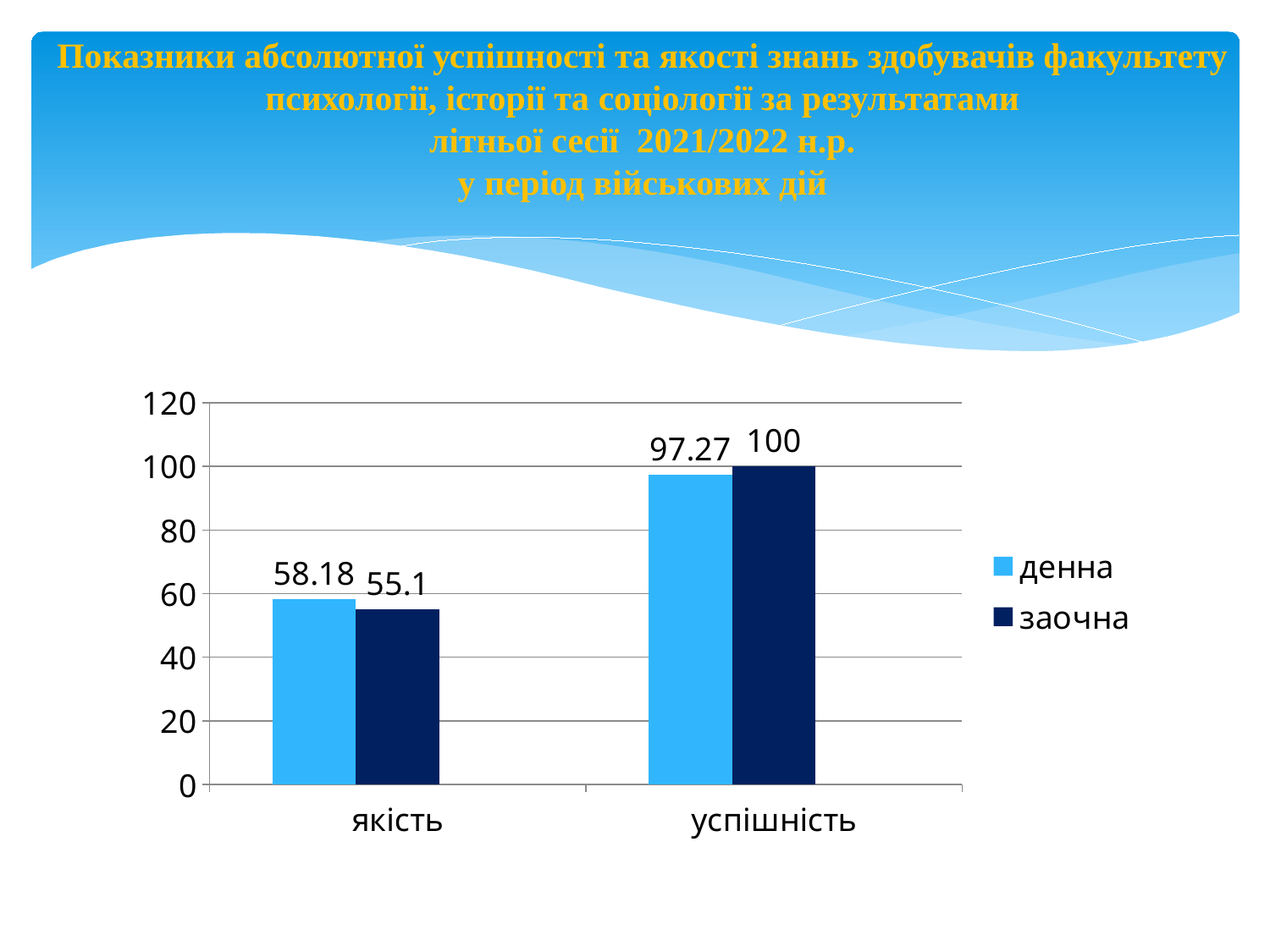
What is the value for заочна in the успішність category? 100 What is the difference between the заочна and денна values in the успішність category? 2.73 What kind of chart is shown on the slide? bar chart Which category has the lowest value for заочна? якість What is the value for денна in the якість category? 58.18 Which series has the higher value in the успішність category? заочна What is the value for заочна in the якість category? 55.1 What is the value for денна in the успішність category? 97.27 Which series has the higher value in the якість category? денна How many series does the legend list? 2 What is the difference between the денна and заочна values in the якість category? 3.08 How many categories are shown on the x axis? 2